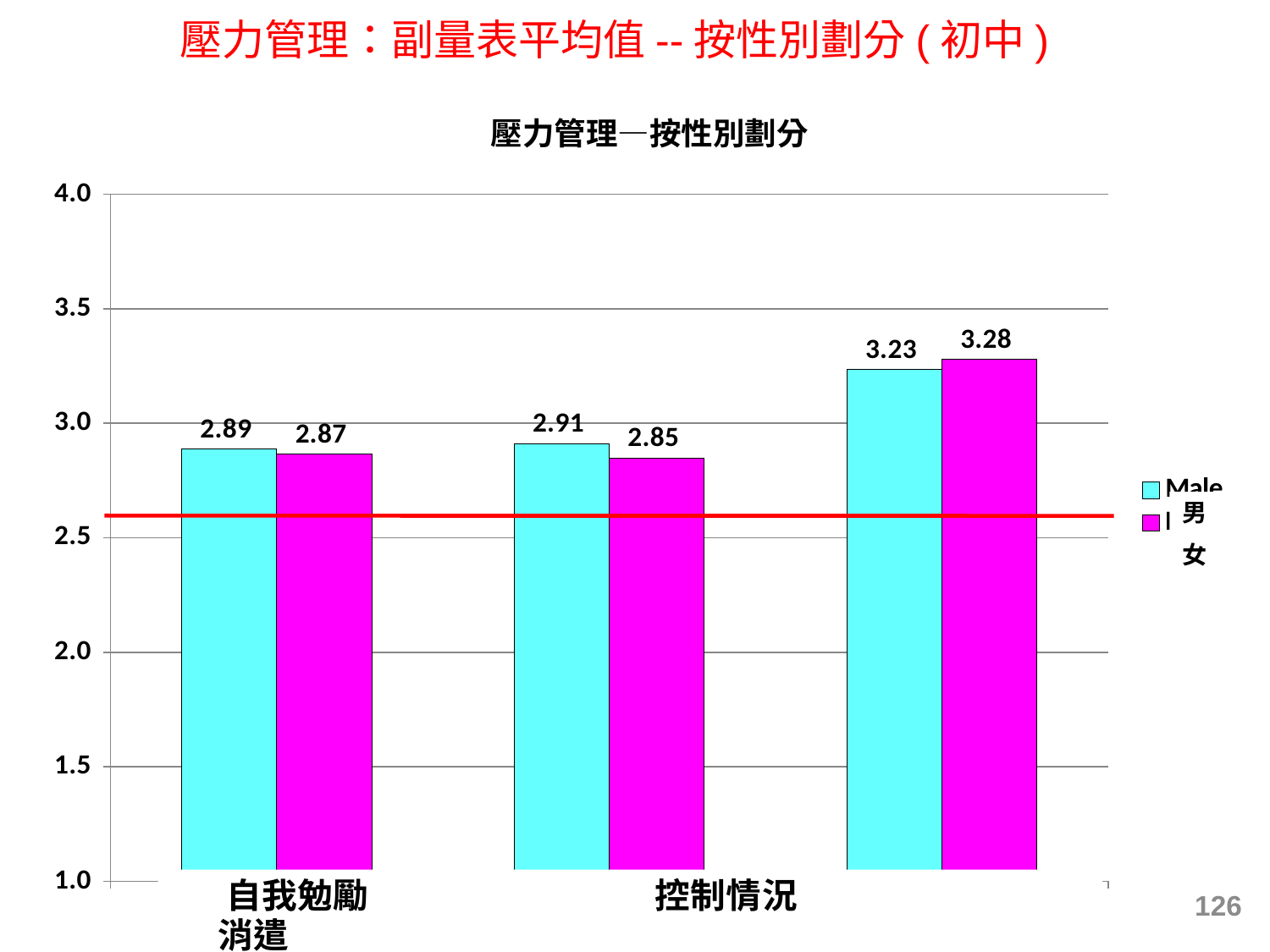
What is the difference between the 男 and 女 values in the 自我勉勵 category? 0.02 What is the title of the chart? 壓力管理─按性別劃分 What is the value for 男 (Male) in the 自我勉勵 category? 2.89 Is the value for 男 in the 控制情況 category greater or less than 2.5? greater What is the value for 女 in the 控制情況 category? 2.85 How many series does the legend list? 2 What is the value for 男 (Male) in the 控制情況 category? 2.91 What is the difference between the 男 and 女 values in the 控制情況 category? 0.06 What kind of chart is shown on the slide? bar chart What is the highest value labelled on the chart? 3.28 What is the value for 女 in the 自我勉勵 category? 2.87 In the 控制情況 category, which is larger, the 男 value or the 女 value? 男